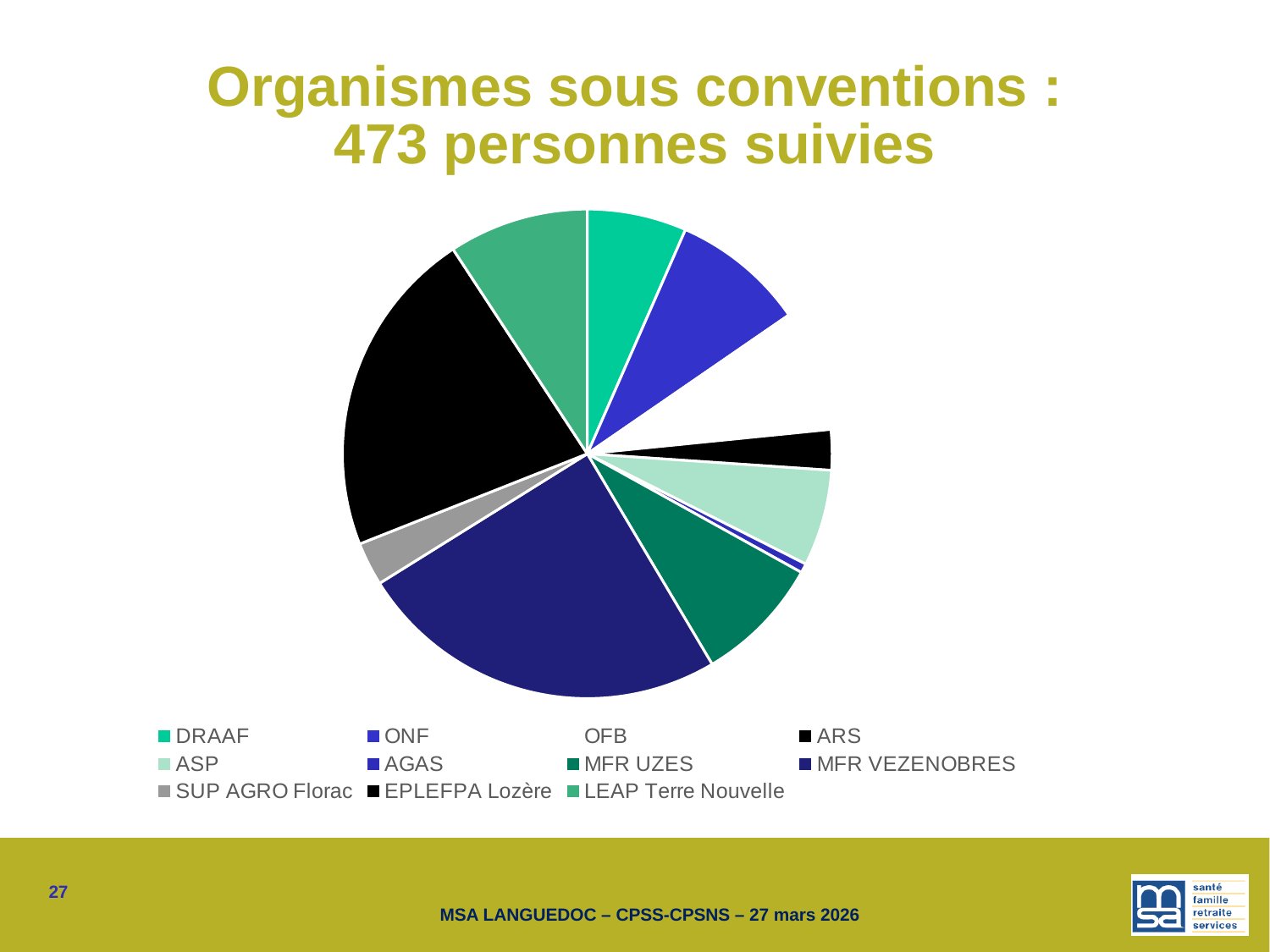
How many entries does the legend of the pie chart list? 11 What kind of chart is shown on the slide? pie chart What is the title of the slide containing the pie chart? Organismes sous conventions : 473 personnes suivies Which slice is larger, EPLEFPA Lozère or SUP AGRO Florac? EPLEFPA Lozère Which slice is larger, ONF or AGAS? ONF Which slice is larger, MFR UZES or ARS? MFR UZES How many slices (organisations) does the pie chart have? 11 According to the slide title, how many people are followed in total across the organisations in the pie chart? 473 Which organisation has the smallest slice in the pie chart? AGAS